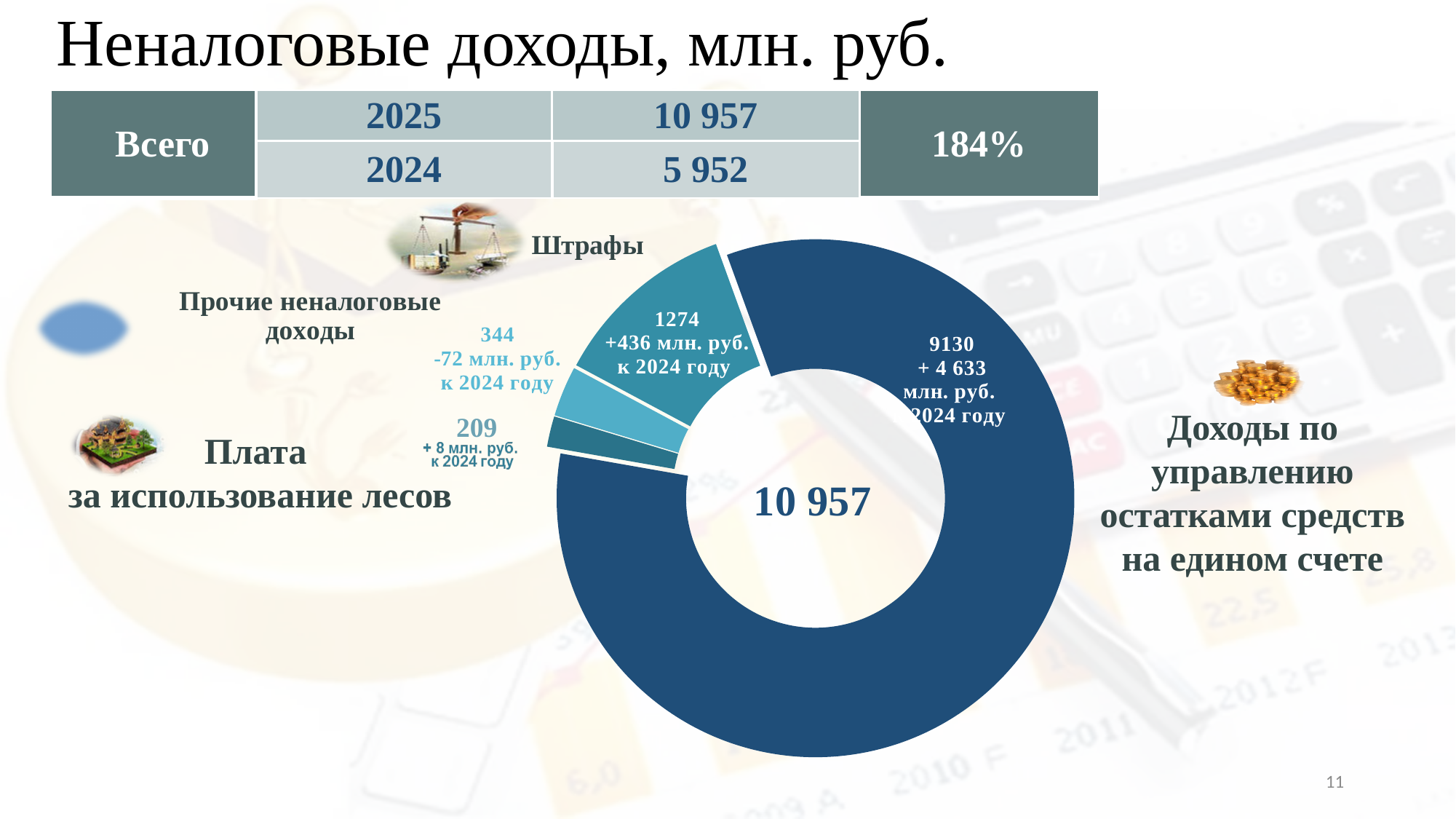
Какое значение указано для сектора «Доходы по управлению остатками средств на едином счете»? 9130 Что больше: «Прочие неналоговые доходы» или «Плата за использование лесов»? Прочие неналоговые доходы Какое значение указано для сектора «Плата за использование лесов»? 209 Какое значение указано для сектора «Прочие неналоговые доходы»? 344 На сколько значение «Штрафы» больше значения «Прочие неналоговые доходы»? 930 Какое общее значение указано в центре кольцевой диаграммы? 10 957 Какая категория имеет наименьшее значение на диаграмме? Плата за использование лесов Какой тип диаграммы показан на слайде? Кольцевая (круговая) диаграмма На сколько млн. руб. изменились «Штрафы» к 2024 году согласно подписи на диаграмме? +436 млн. руб. Сколько секторов (категорий) показано на кольцевой диаграмме? 4 Какое значение указано для сектора «Штрафы»? 1274 Какая категория имеет наибольшее значение на диаграмме? Доходы по управлению остатками средств на едином счете